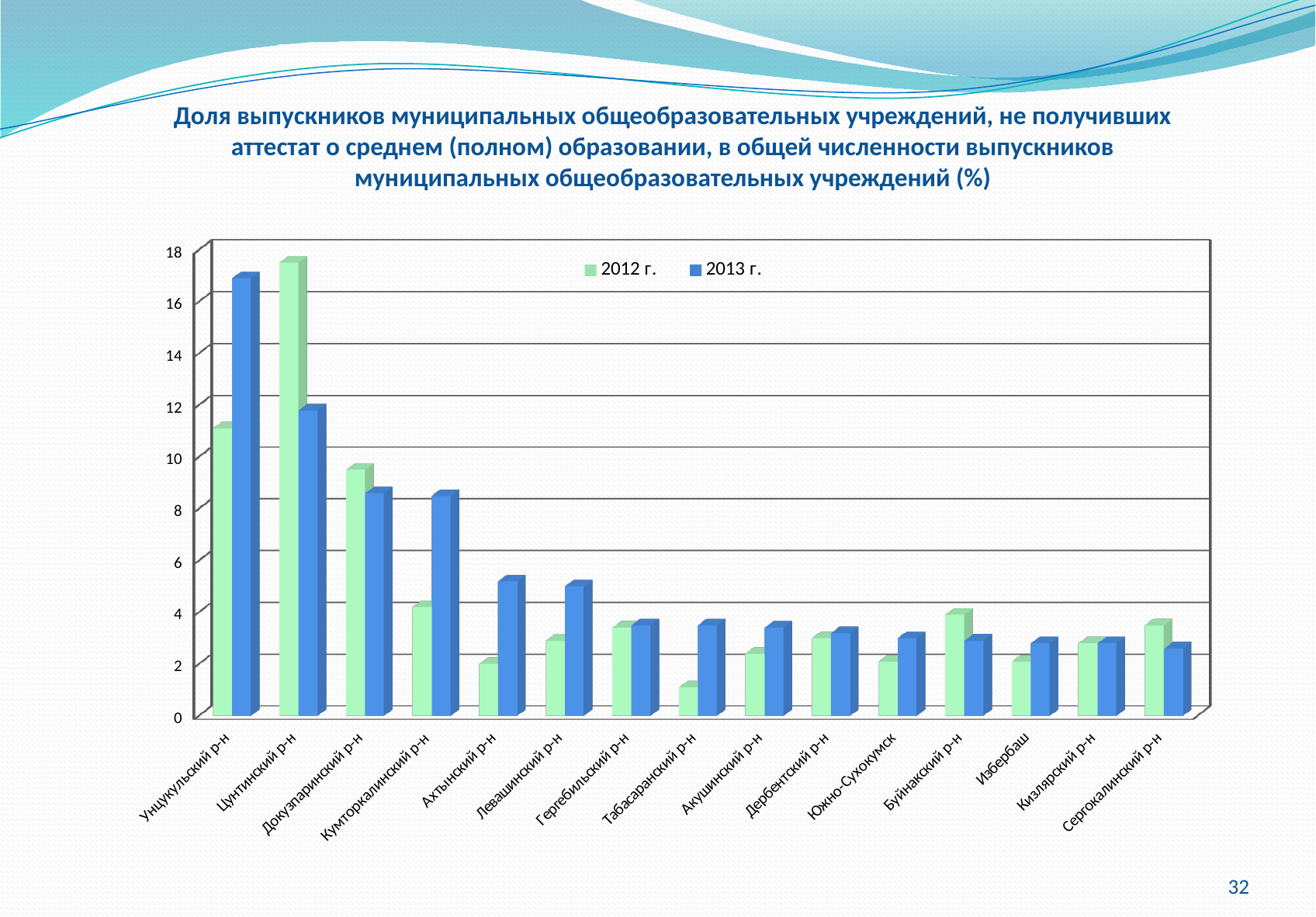
Is the 2013 г. value for Унцукульский р-н greater or less than 16? greater For Кумторкалинский р-н, which year has the larger value, 2012 г. or 2013 г.? 2013 г. Is the 2012 г. value for Цунтинский р-н greater or less than 16? greater What are the two entries in the chart legend? 2012 г. and 2013 г. Which district has the lowest value for 2012 г.? Табасаранский р-н Which district has the highest value for 2013 г.? Унцукульский р-н For Цунтинский р-н, which year has the larger value, 2012 г. or 2013 г.? 2012 г. How many districts (categories) are shown on the x axis? 15 How many series does the legend list? 2 Is the 2012 г. value for Табасаранский р-н greater or less than 2? less What kind of chart is shown on the slide? bar chart Which district has the highest value for 2012 г.? Цунтинский р-н